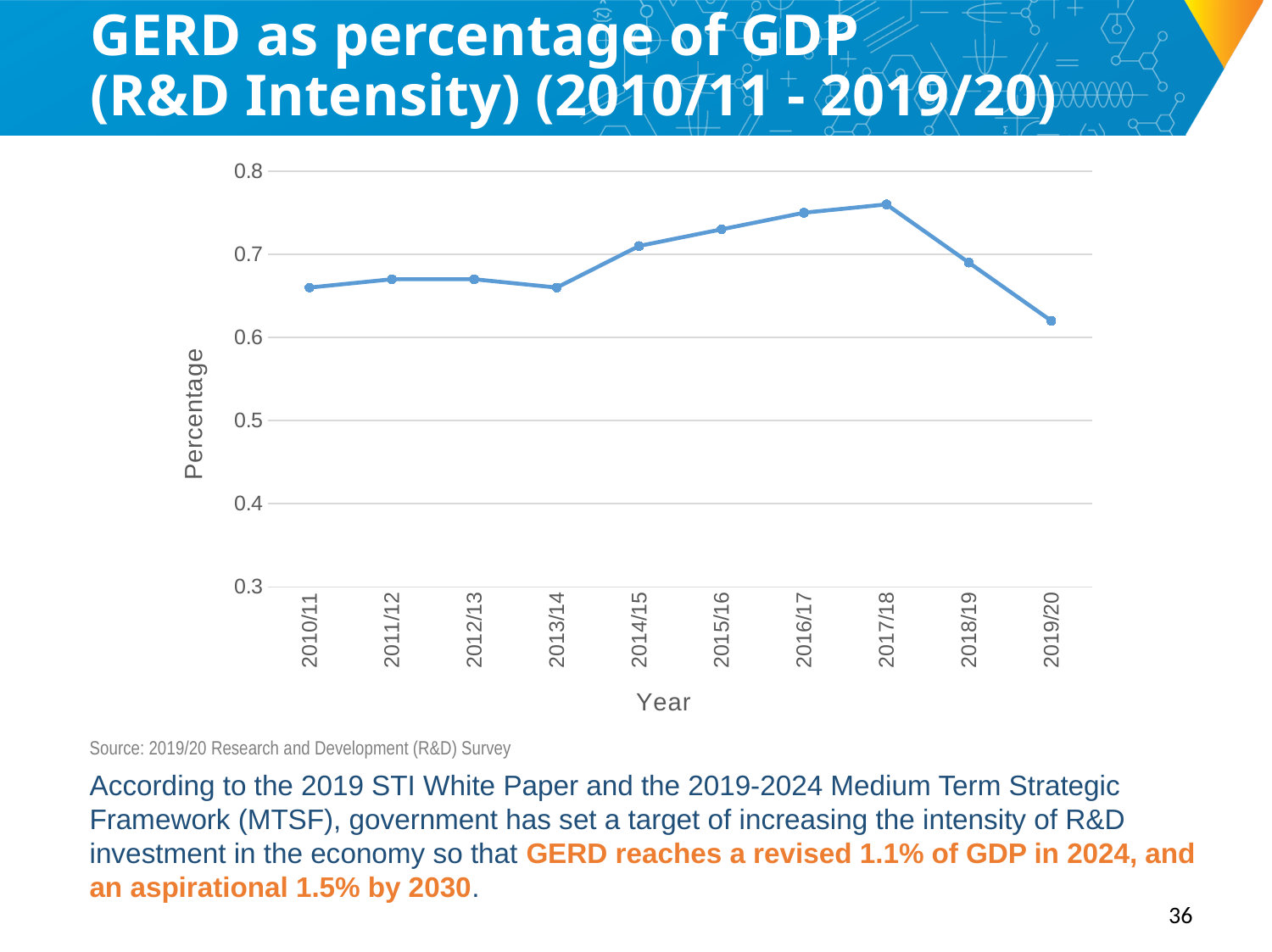
Is the value for 2013/14 greater or less than 0.7? less Is the value for 2019/20 greater or less than 0.6? greater How many years are plotted on the x axis of the chart? 10 Which year has the lowest GERD as a percentage of GDP? 2019/20 Do the values rise or fall from 2013/14 to 2017/18? rise Which year has the highest GERD as a percentage of GDP? 2017/18 Which year has the larger value, 2016/17 or 2013/14? 2016/17 Is the value for 2010/11 greater or less than 0.7? less What kind of chart is shown on the slide? Line chart Do the values rise or fall from 2017/18 to 2019/20? fall What is the label on the vertical axis of the chart? Percentage